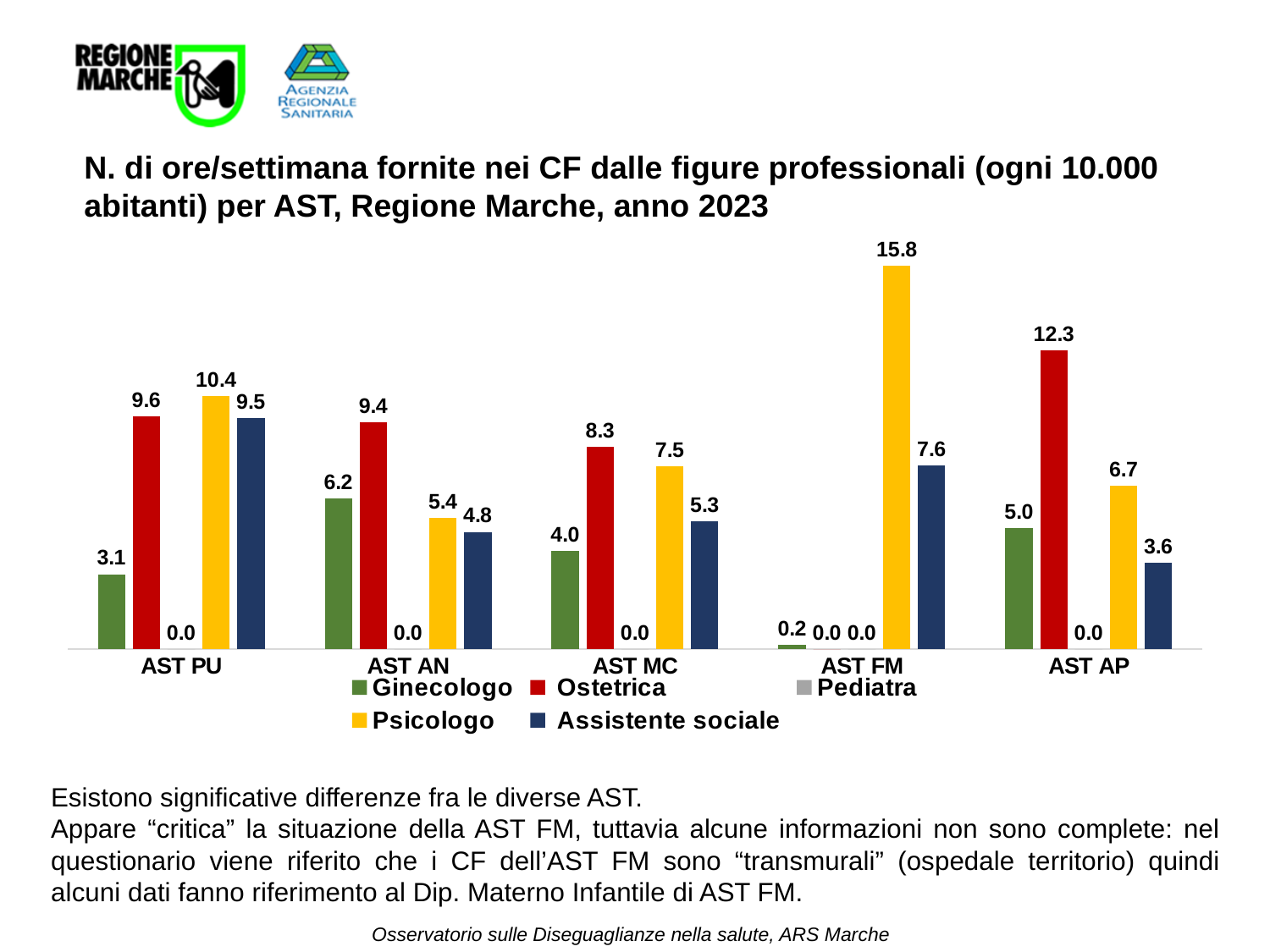
Which is larger: the Ostetrica value for AST PU or the Ostetrica value for AST AN? AST PU What is the value for Ginecologo in AST AN? 6.2 What type of chart is shown on the slide? bar chart Which AST has the lowest value for Ginecologo? AST FM What is the value for Assistente sociale in AST MC? 5.3 How many AST categories are shown on the x axis? 5 What is the difference between the Psicologo values for AST FM and AST PU? 5.4 How many series does the legend list? 5 What is the value for Psicologo in AST FM? 15.8 What is the value for Ostetrica in AST AP? 12.3 Which AST has the highest value for Ostetrica? AST AP Which series has a value of 0.0 in every AST? Pediatra